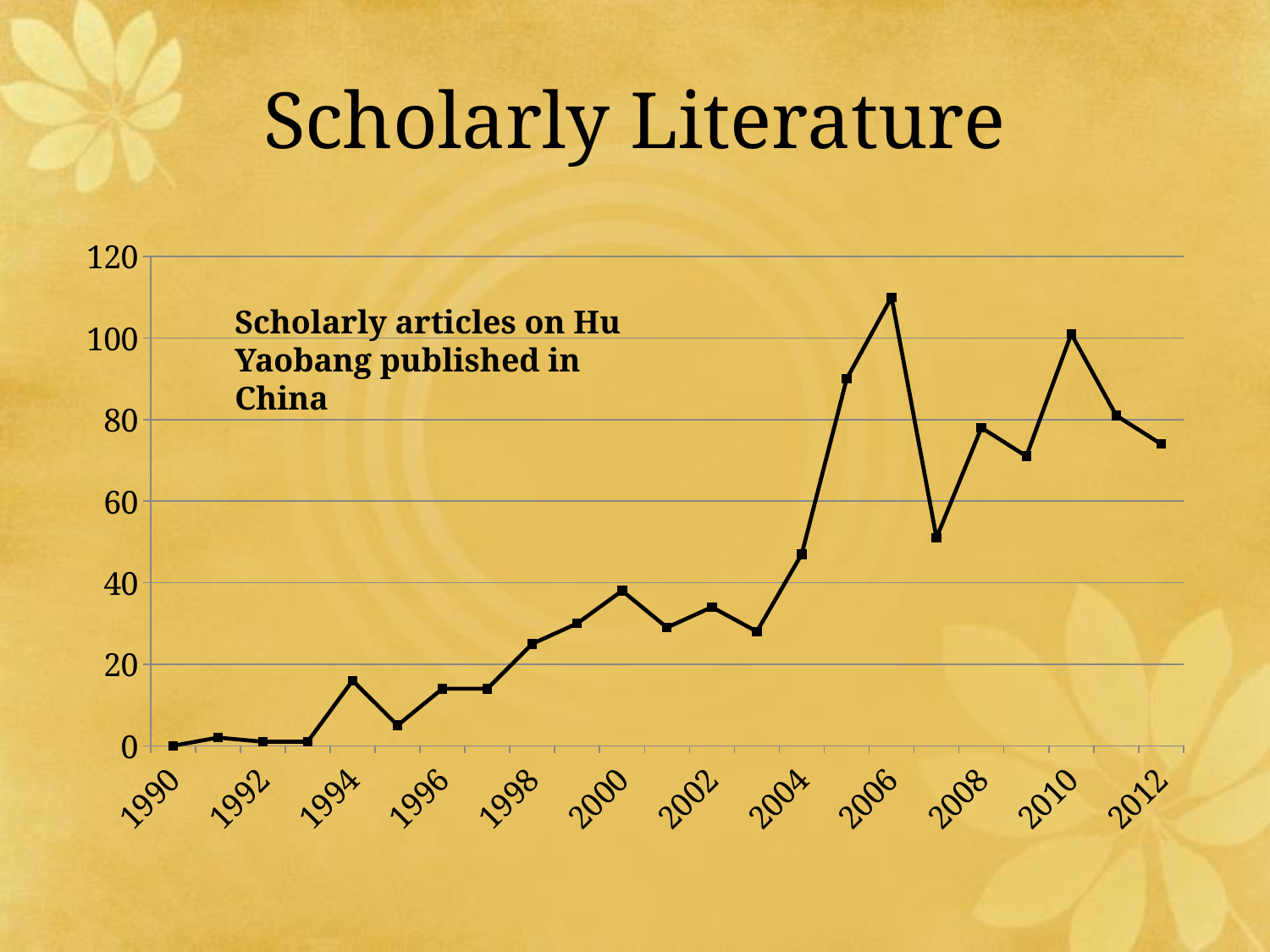
Which year has a higher value, 2005 or 2007? 2005 What kind of chart is shown on the slide? Line chart What does the text label inside the chart say the data represents? Scholarly articles on Hu Yaobang published in China Is the value for 2004 greater or less than 40? greater Which year has a higher value, 2006 or 2010? 2006 Is the value for 2012 greater or less than 80? less Which year has the highest number of scholarly articles on Hu Yaobang? 2006 Overall, do the values rise or fall from 1990 to 2012? Rise Which year has the lowest number of scholarly articles on Hu Yaobang? 1990 Is the value for 2005 greater or less than 80? greater